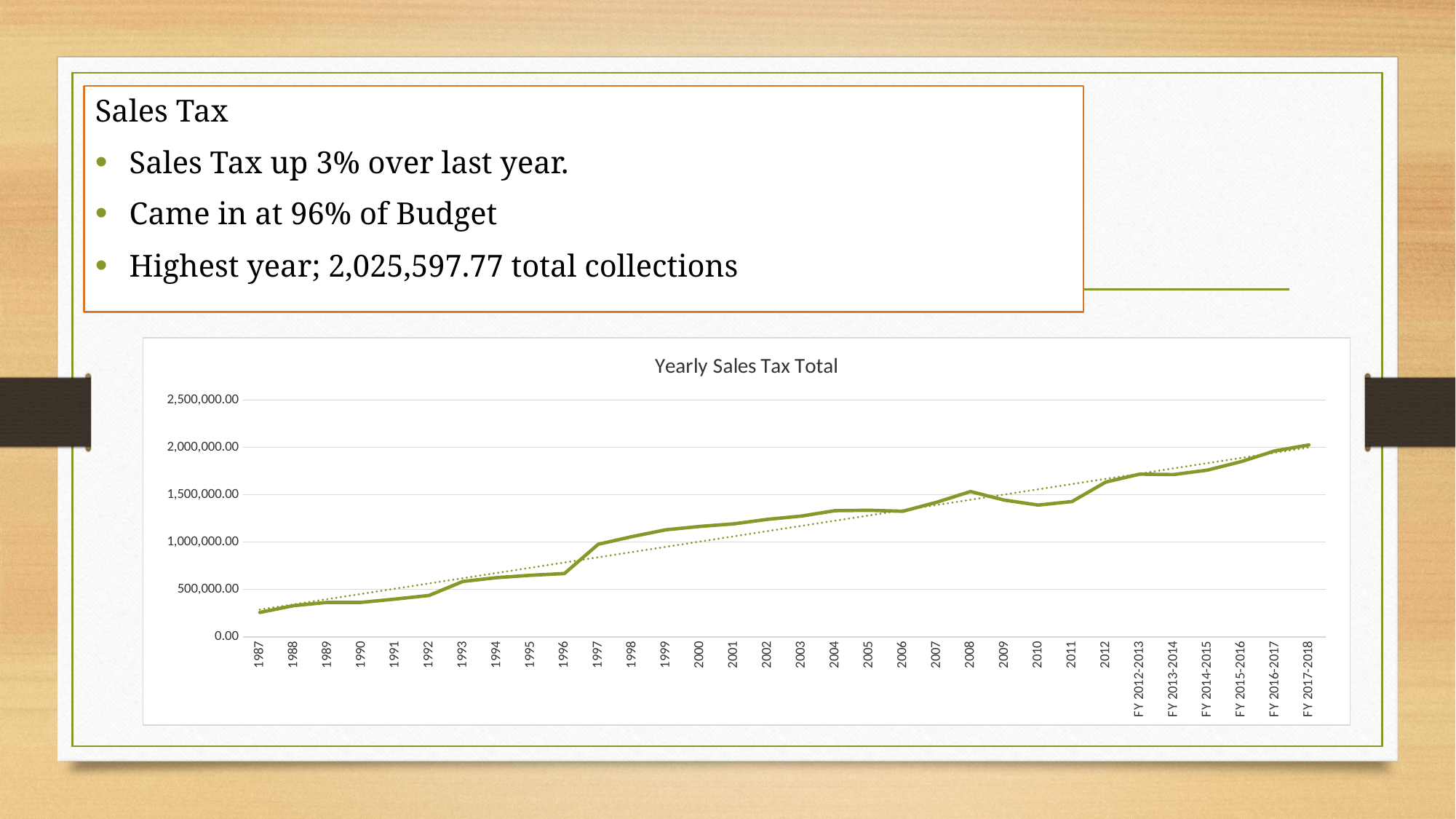
Which year has the lowest yearly sales tax total in the chart? 1987 Is the value for 2004 greater or less than 1,500,000.00? less How many years (data points) are plotted along the x axis of the chart? 32 What kind of chart is shown on the slide? line chart Overall, do the yearly sales tax totals rise or fall from 1987 to FY 2017-2018? rise Which year has the highest yearly sales tax total in the chart? FY 2017-2018 What is the title of the chart? Yearly Sales Tax Total Is the value for 2010 greater or less than 1,500,000.00? less What is the highest value shown on the chart's vertical axis? 2,500,000.00 Is the value for 1999 greater or less than 1,000,000.00? greater Which year has the larger sales tax total, 2008 or 2010? 2008